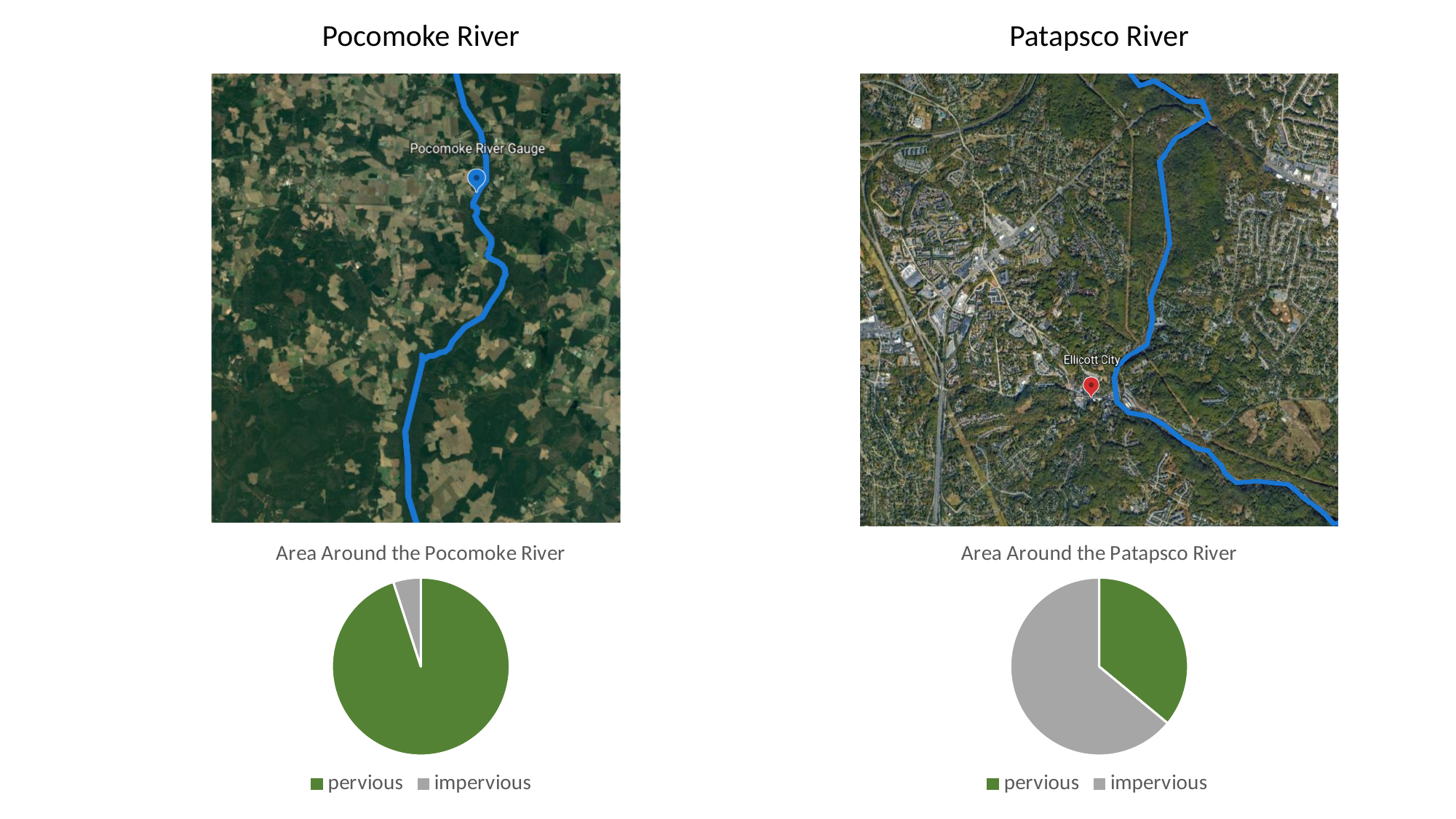
In the "Area Around the Pocomoke River" chart, which category has the largest slice? pervious How many categories does the legend of the "Area Around the Patapsco River" chart list? 2 In the "Area Around the Patapsco River" chart, what colour represents impervious? grey What kind of chart is the "Area Around the Pocomoke River" chart? pie chart In the "Area Around the Patapsco River" chart, which category has the largest slice? impervious In the "Area Around the Pocomoke River" chart, which is larger, pervious or impervious? pervious In the "Area Around the Patapsco River" chart, which category has the smallest slice? pervious How many slices does the "Area Around the Pocomoke River" pie chart have? 2 What is the title of the pie chart on the left side of the slide? Area Around the Pocomoke River In the "Area Around the Patapsco River" chart, which is larger, pervious or impervious? impervious In the "Area Around the Pocomoke River" chart, which category has the smallest slice? impervious What kind of chart is the "Area Around the Patapsco River" chart? pie chart